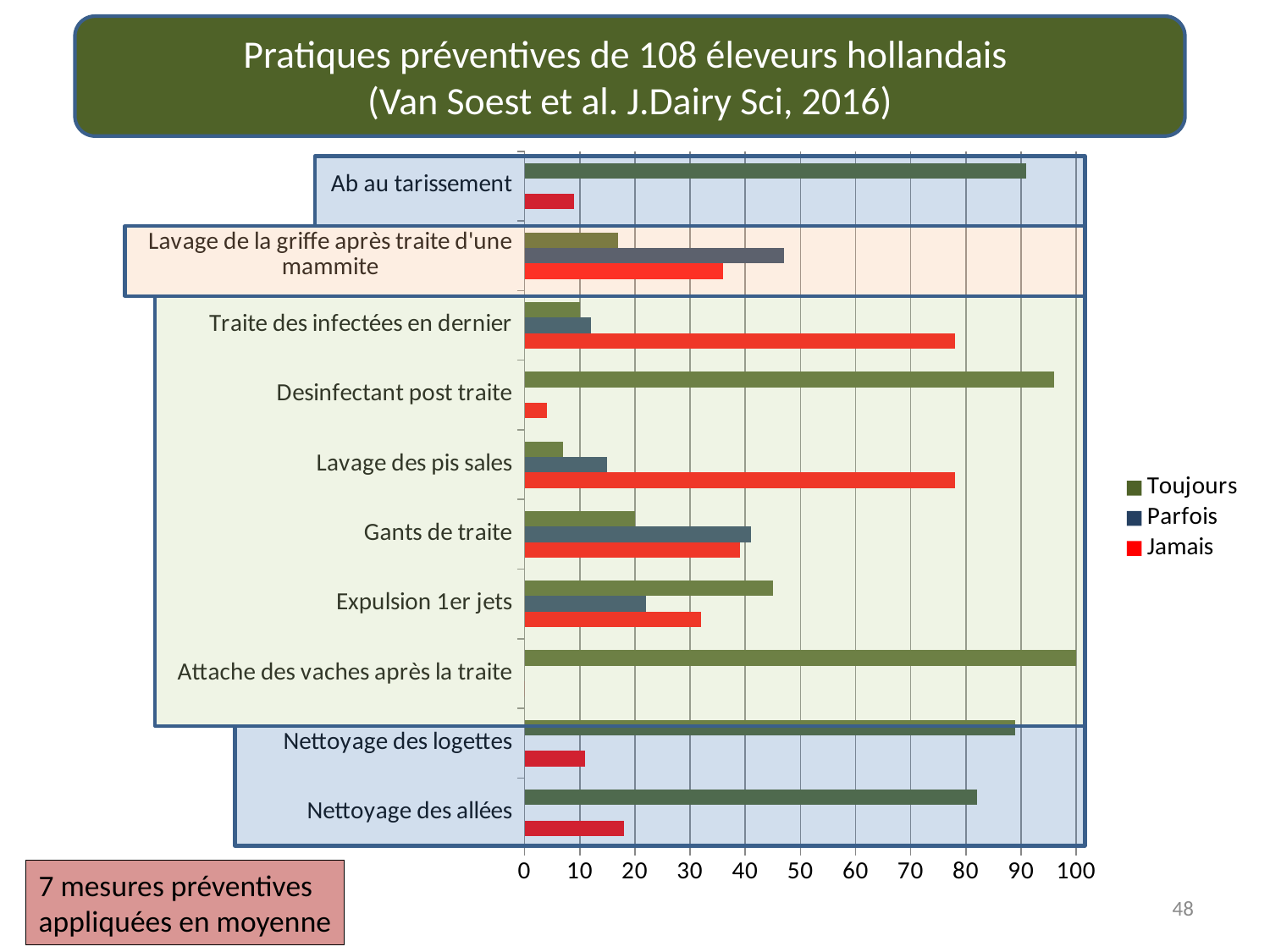
Is the 'Toujours' value for 'Desinfectant post traite' greater or less than 90? greater Is the 'Jamais' value for 'Desinfectant post traite' greater or less than 10? less For 'Expulsion 1er jets', which is larger: 'Toujours' or 'Jamais'? Toujours For 'Gants de traite', which is larger: 'Toujours' or 'Parfois'? Parfois What colour represents the 'Jamais' series in the legend? red How many practices (categories) are shown on the chart? 10 Is the 'Toujours' value for 'Nettoyage des allées' greater or less than 70? greater What kind of chart is shown on the slide? bar chart Which practice has the highest 'Toujours' value? Attache des vaches après la traite How many series does the legend list? 3 For 'Lavage de la griffe après traite d'une mammite', which is larger: 'Parfois' or 'Jamais'? Parfois